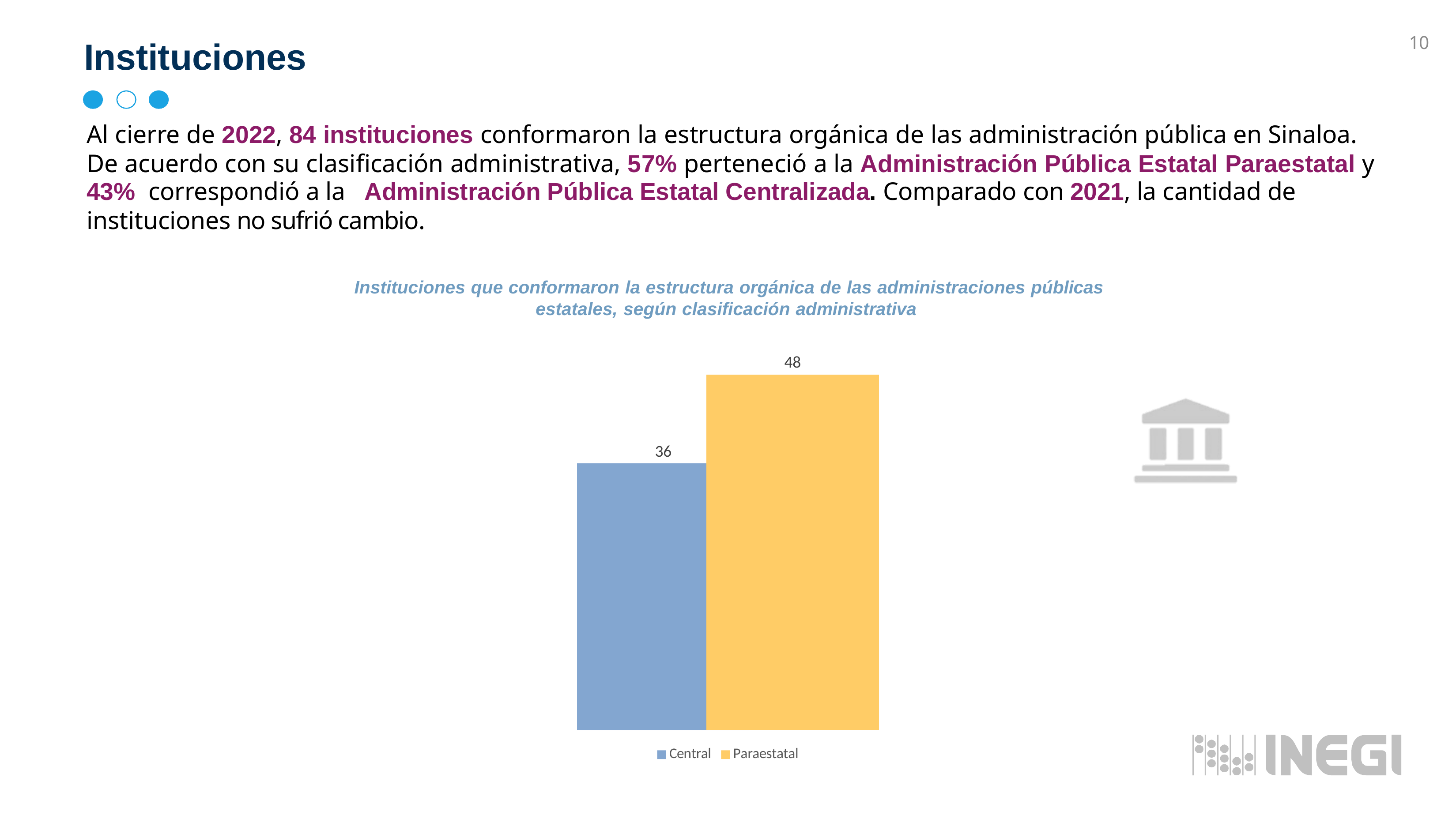
What is the total of the Central and Paraestatal values in the chart? 84 Which series has the lowest value in the chart? Central What is the difference between the Paraestatal and Central values? 12 Which series has the highest value in the chart? Paraestatal What kind of chart is shown on the slide? Bar chart Which is larger, the value for Central or the value for Paraestatal? Paraestatal What colour is the Central bar in the chart? Blue What is the value for Paraestatal in the chart? 48 How many series does the legend list? 2 What is the value for Central in the chart? 36 What colour is the Paraestatal bar in the chart? Yellow